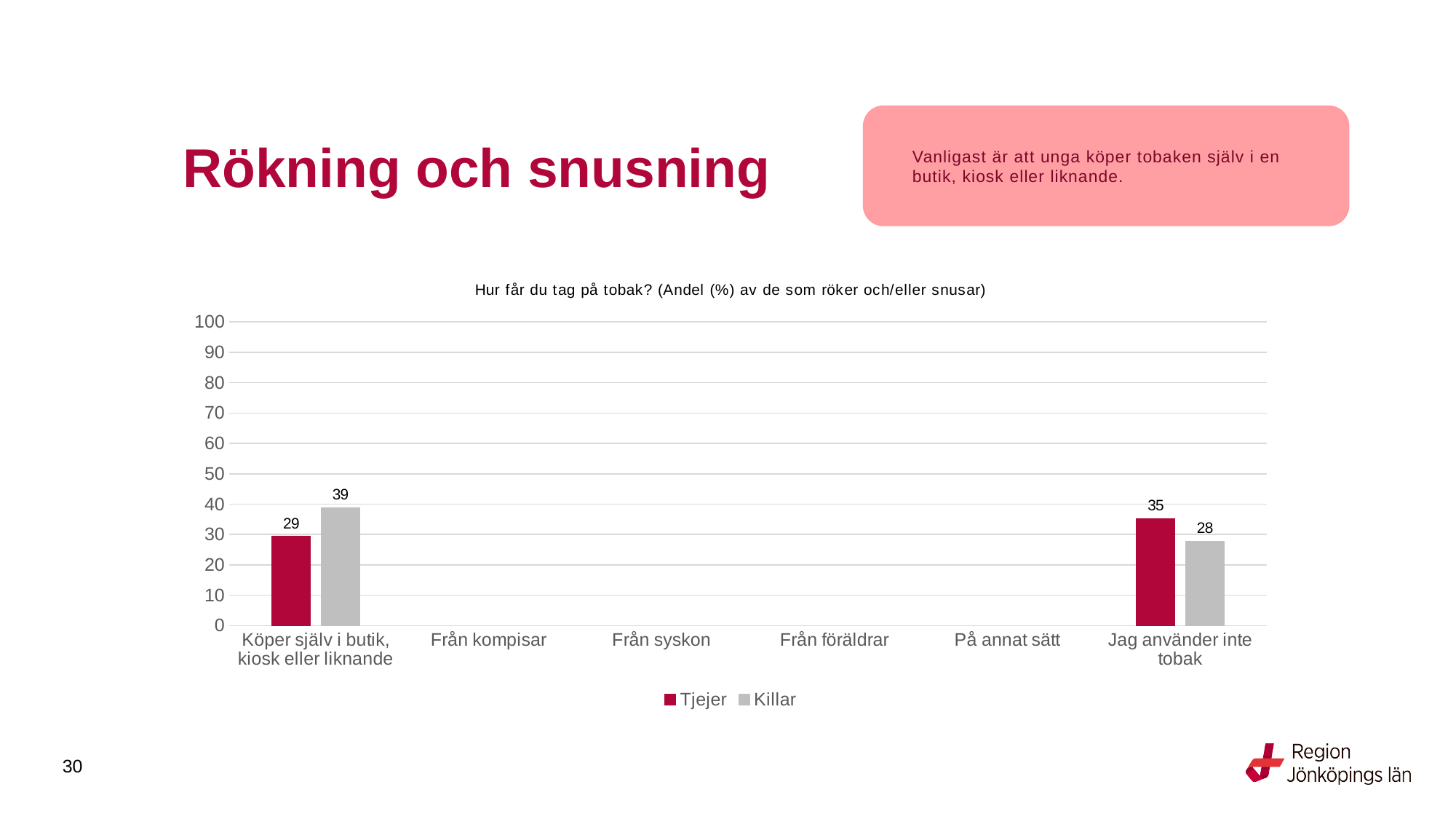
Is the value for Killar in "Köper själv i butik, kiosk eller liknande" greater or less than 30? greater How many series does the chart legend list? 2 What type of chart is shown on the slide? Bar chart Which series has the larger value in the category "Jag använder inte tobak", Tjejer or Killar? Tjejer What is the difference between the Tjejer and Killar values for "Jag använder inte tobak"? 7 What is the value for Tjejer in the category "Jag använder inte tobak"? 35 What is the value for Killar in the category "Jag använder inte tobak"? 28 What is the value for Tjejer in the category "Köper själv i butik, kiosk eller liknande"? 29 How many categories are shown on the x axis of the chart? 6 Which series has the larger value in the category "Köper själv i butik, kiosk eller liknande", Tjejer or Killar? Killar What is the value for Killar in the category "Köper själv i butik, kiosk eller liknande"? 39 What is the difference between the Killar and Tjejer values for "Köper själv i butik, kiosk eller liknande"? 10